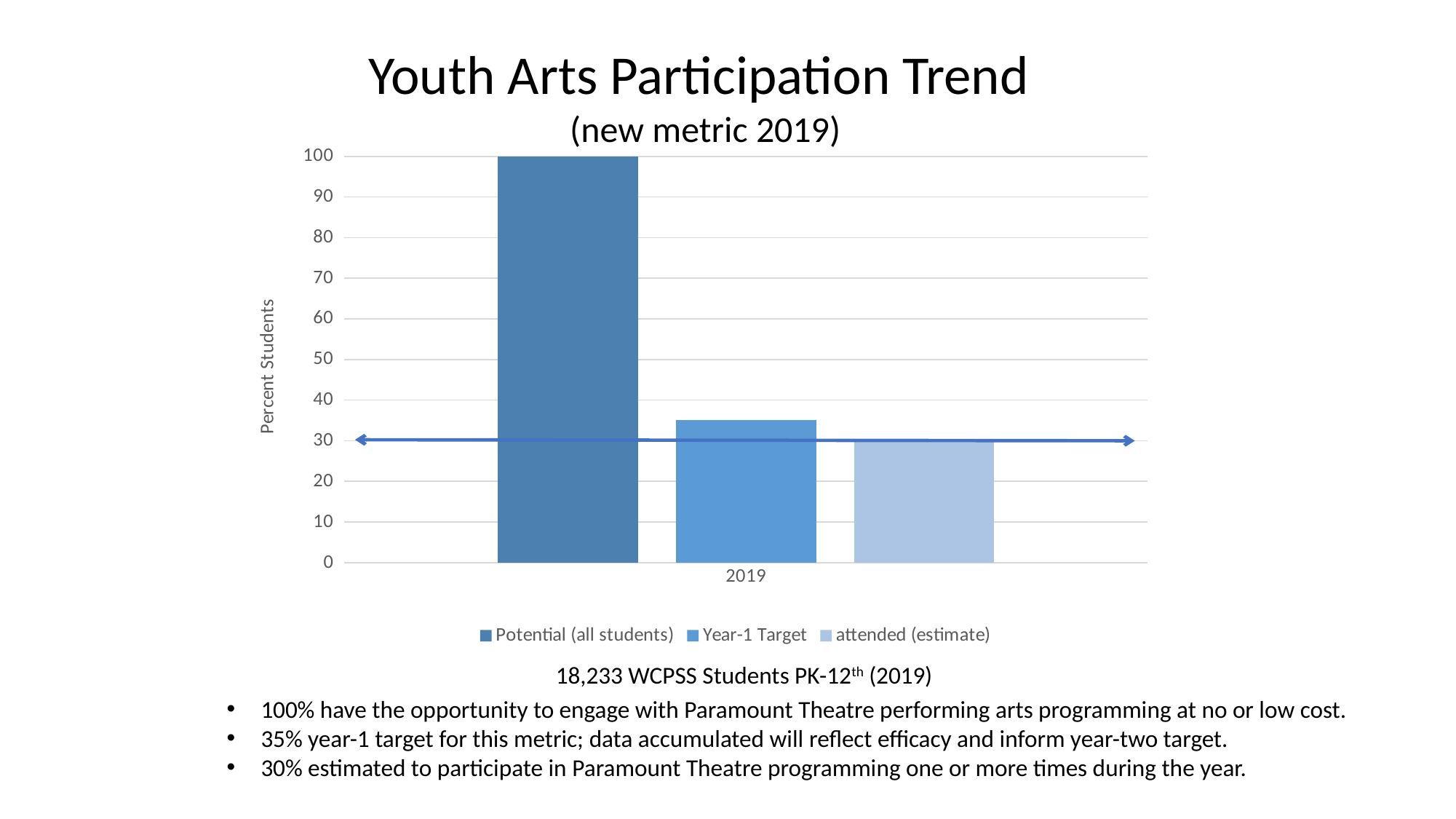
What is the difference between Potential (all students) and attended (estimate)? 70 What is the value for Potential (all students) in 2019? 100 What type of chart is shown on the slide? bar chart What is the label on the vertical axis? Percent Students Which series has the lowest value in 2019? attended (estimate) Is the value for Year-1 Target greater or less than 30? greater What is the value for Year-1 Target in 2019? 35 Which series has the highest value in 2019? Potential (all students) How many series does the legend list? 3 Which is larger, Year-1 Target or attended (estimate)? Year-1 Target Is the value for attended (estimate) greater or less than 50? less What is the value for attended (estimate) in 2019? 30